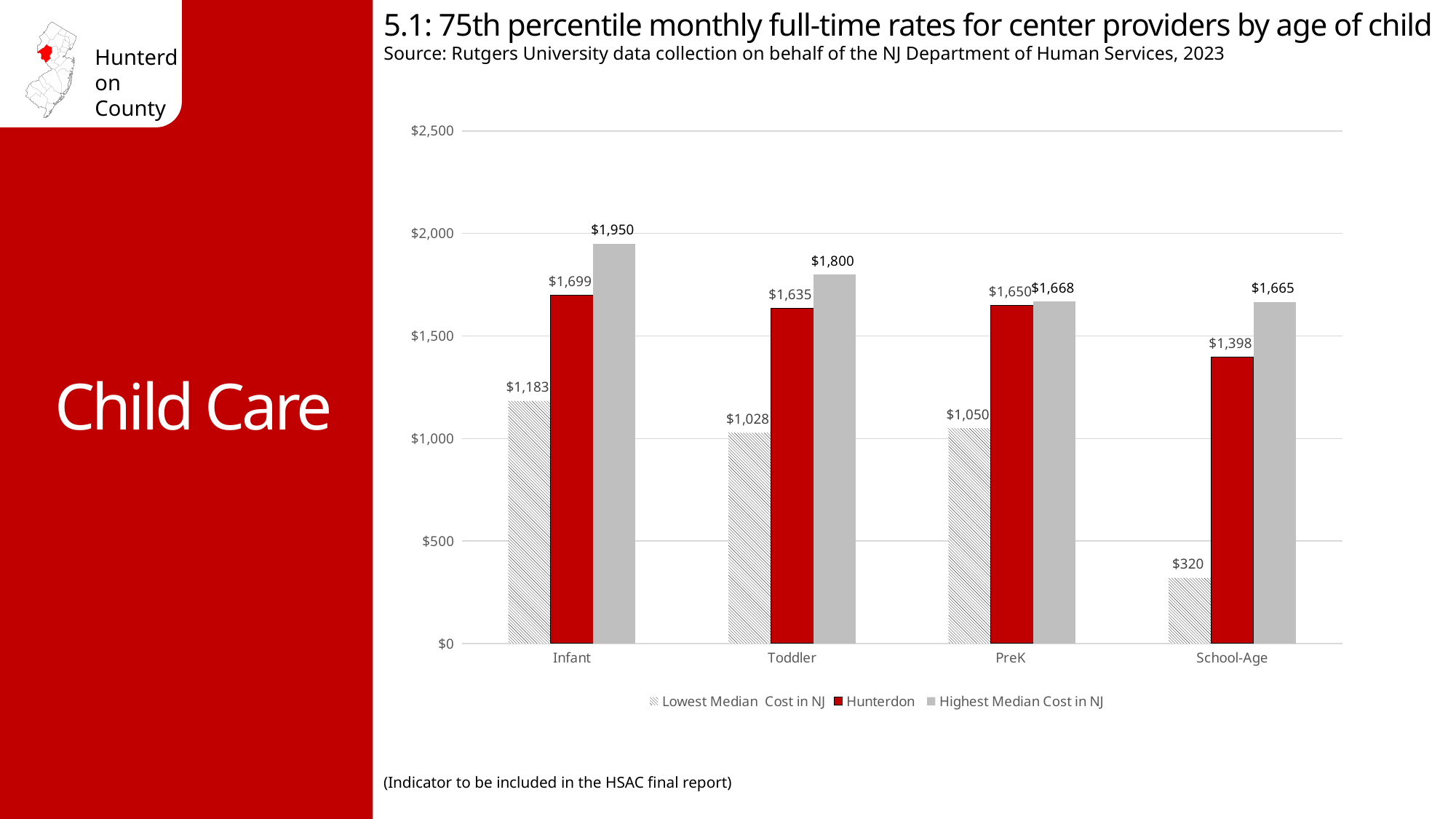
What is the Lowest Median Cost in NJ for School-Age? $320 What is the difference between the Highest Median Cost in NJ and the Hunterdon value for Infant? $251 What is the Hunterdon value for Infant? $1,699 What kind of chart is shown? Bar chart What is the Highest Median Cost in NJ for Toddler? $1,800 Which age group has the highest Hunterdon value? Infant Which age group has the lowest Lowest Median Cost in NJ value? School-Age Which is larger for Toddler: the Hunterdon value or the Lowest Median Cost in NJ? Hunterdon How many series does the legend list? 3 How many age groups are shown on the x axis? 4 What is the Hunterdon value for PreK? $1,650 Which series is shown in red? Hunterdon